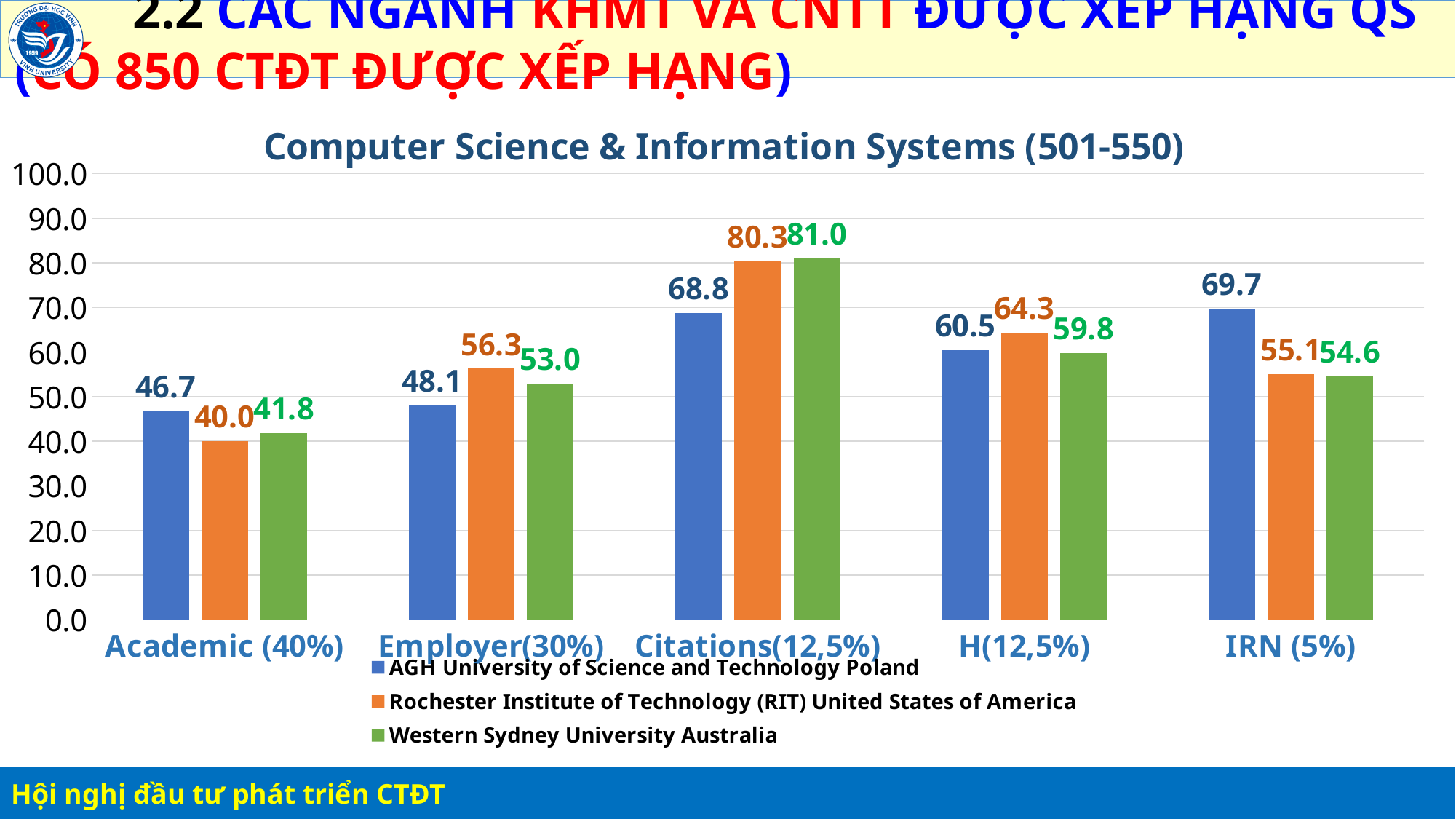
How many series does the legend list? 3 What is the difference between the Rochester Institute of Technology (RIT) and AGH University values in the Employer(30%) category? 8.2 What is the value for Western Sydney University Australia in the Employer(30%) category? 53.0 How many categories are shown on the x axis? 5 What is the value for AGH University of Science and Technology Poland in the Citations(12,5%) category? 68.8 What kind of chart is shown on the slide? Bar chart Which colour represents Western Sydney University Australia in the chart? Green In the IRN (5%) category, which university has the larger value: AGH University of Science and Technology Poland or Western Sydney University Australia? AGH University of Science and Technology Poland Which category has the lowest value for Rochester Institute of Technology (RIT) United States of America? Academic (40%) What is the value for Rochester Institute of Technology (RIT) United States of America in the H(12,5%) category? 64.3 What is the title of the chart? Computer Science & Information Systems (501-550) Which category has the highest value for Western Sydney University Australia? Citations(12,5%)